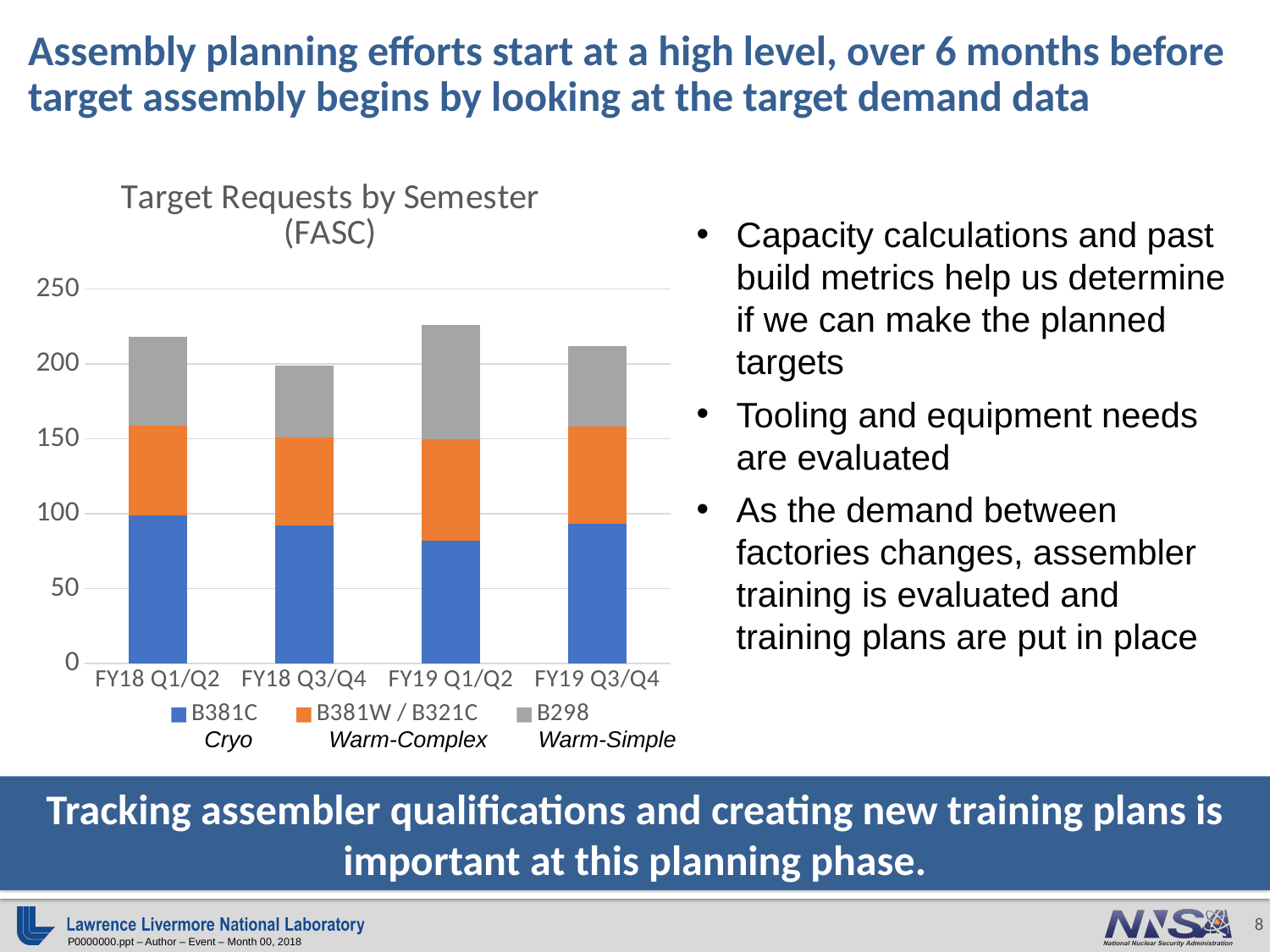
Which semester has the highest total stacked bar? FY19 Q1/Q2 What is the title of the chart? Target Requests by Semester (FASC) Is the total bar for FY19 Q3/Q4 greater or less than 250? less Which is larger, the total bar for FY18 Q3/Q4 or the total bar for FY19 Q1/Q2? FY19 Q1/Q2 Which semester has the lowest total stacked bar? FY18 Q3/Q4 Is the B381C value for FY19 Q1/Q2 greater or less than 100? less How many semesters (categories) are shown on the x axis? 4 What kind of chart is shown on the slide? stacked bar chart Is the total bar for FY19 Q1/Q2 greater or less than 200? greater How many series does the chart legend list? 3 Which legend entry is shown in orange? B381W / B321C